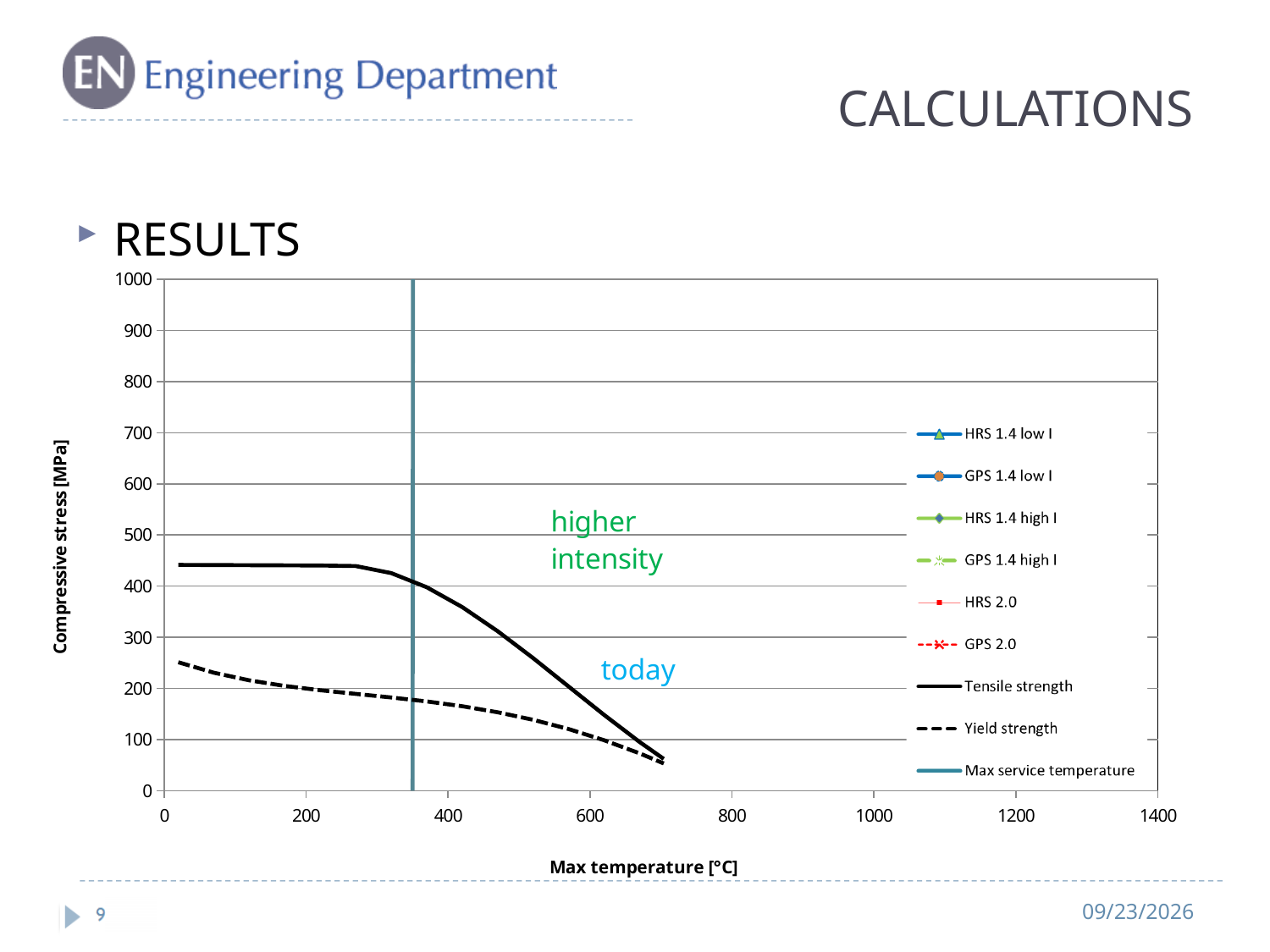
Does the Tensile strength curve rise or fall as Max temperature increases from 400 to 700? fall Is the Tensile strength value at 600 °C greater or less than 300? less Which legend entry is drawn as a dashed black line? Yield strength Is the Tensile strength value at 200 °C greater or less than 400? greater Does the Yield strength curve rise or fall as Max temperature increases along the x axis? fall What is the title of the y axis? Compressive stress [MPa] Is the Yield strength value at 200 °C greater or less than 300? less What is the title of the x axis? Max temperature [°C] What kind of chart is shown on the slide? line chart How many series does the legend list? 9 At 400 °C, which is larger: Tensile strength or Yield strength? Tensile strength